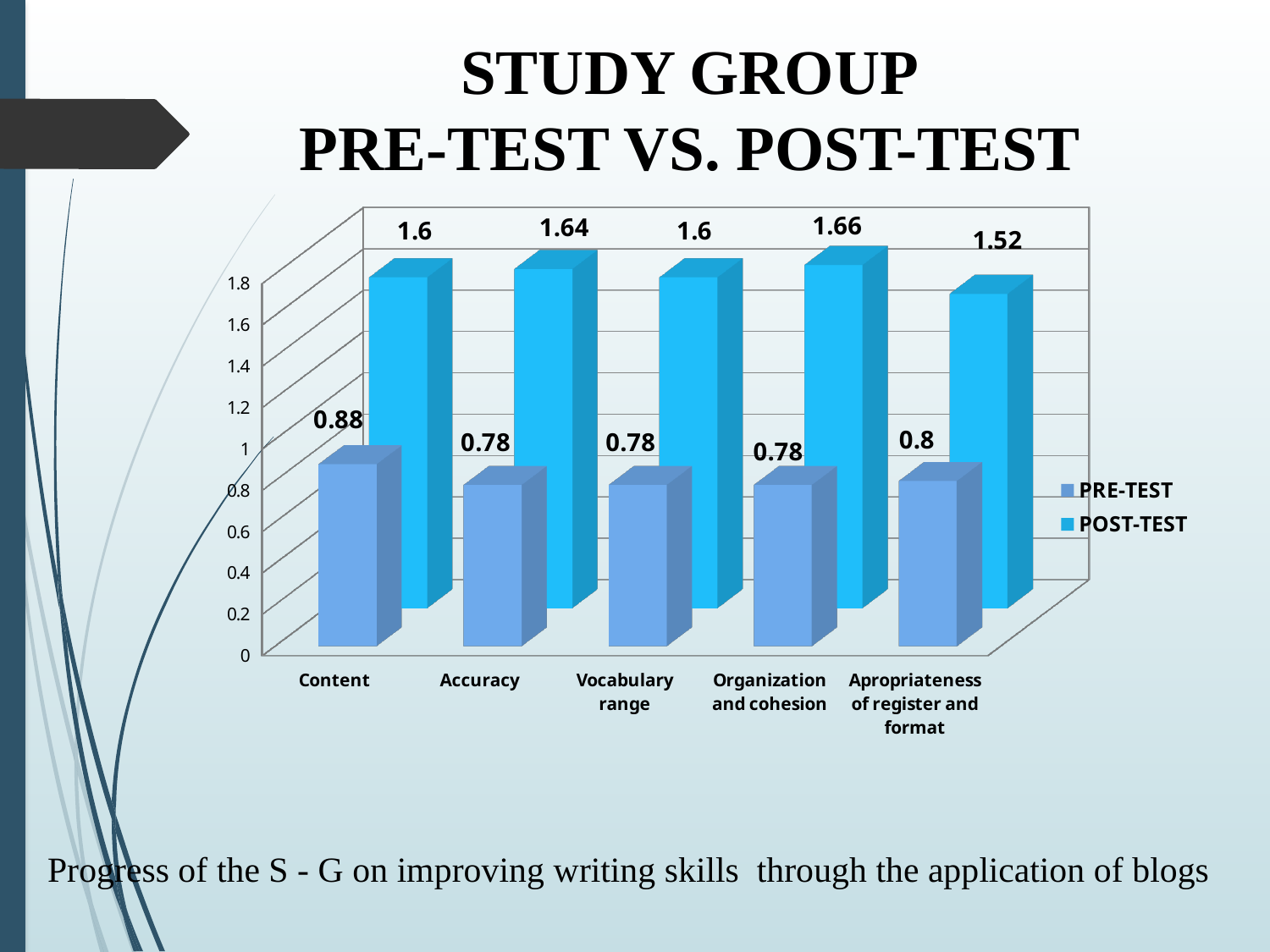
Which category has the highest POST-TEST value? Organization and cohesion What is the POST-TEST value for Apropriateness of register and format? 1.52 How many series does the legend list? 2 What is the difference between the POST-TEST and PRE-TEST values for Content? 0.72 Which category has the highest PRE-TEST value? Content Which category has the lowest POST-TEST value? Apropriateness of register and format What is the POST-TEST value for Accuracy? 1.64 Which is larger, the POST-TEST value for Accuracy or the POST-TEST value for Vocabulary range? Accuracy What kind of chart is shown on the slide? Bar chart What is the PRE-TEST value for Content? 0.88 What is the difference between the POST-TEST and PRE-TEST values for Organization and cohesion? 0.88 How many categories are shown on the x axis? 5